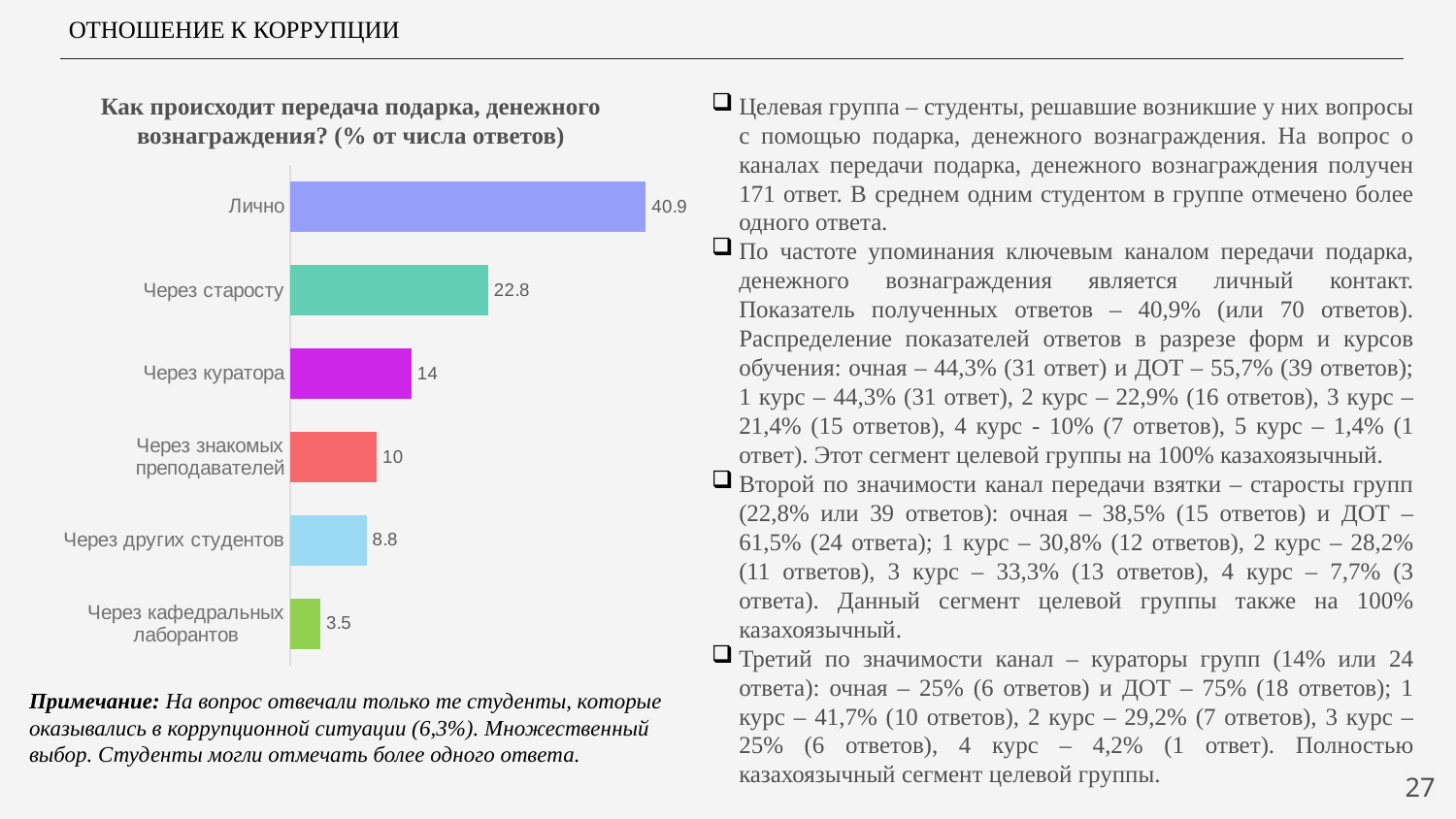
What is the difference between the values for "Через знакомых преподавателей" and "Через других студентов"? 1.2 What is the difference between the values for "Лично" and "Через старосту"? 18.1 What value is shown for "Через кафедральных лаборантов"? 3.5 What value is shown for "Через старосту"? 22.8 Which category has the lowest value? Через кафедральных лаборантов What value is shown for "Через куратора"? 14 What type of chart is shown on the slide? Bar chart What value is shown for the "Лично" bar? 40.9 Which category has the highest value? Лично Which is larger: the value for "Через куратора" or for "Через других студентов"? Через куратора What is the title of the chart? Как происходит передача подарка, денежного вознаграждения? (% от числа ответов) How many categories are shown in the chart? 6